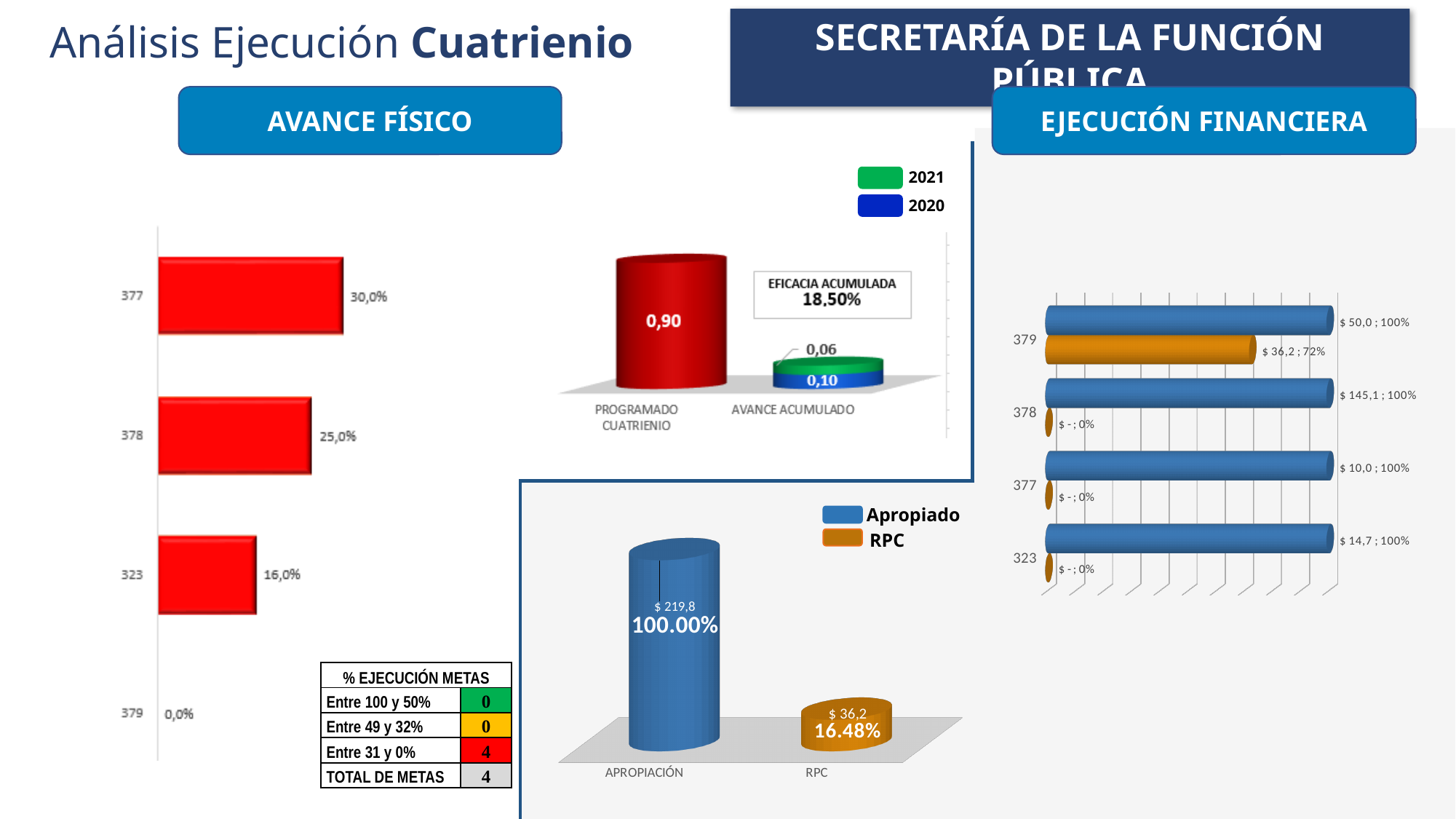
In the cylinder chart with PROGRAMADO CUATRIENIO and AVANCE ACUMULADO, what is the EFICACIA ACUMULADA shown? 18.50% In the cylinder chart with PROGRAMADO CUATRIENIO and AVANCE ACUMULADO, how many series does the legend list? 2 How many categories are shown in the red horizontal bar chart under AVANCE FÍSICO? 4 In the horizontal bar chart under EJECUCIÓN FINANCIERA, what is the RPC value for category 379? $ 36,2 ; 72% In the red horizontal bar chart under AVANCE FÍSICO, what is the difference between the values for 378 and 323? 9,0% In the bottom chart with APROPIACIÓN and RPC, what value is shown for RPC? $ 36,2 In the red horizontal bar chart under AVANCE FÍSICO, what is the value for category 377? 30,0% In the red horizontal bar chart under AVANCE FÍSICO, which category has the lowest value? 379 In the cylinder chart with PROGRAMADO CUATRIENIO and AVANCE ACUMULADO, what is the value for PROGRAMADO CUATRIENIO? 0,90 In the red horizontal bar chart under AVANCE FÍSICO, which category has the highest value? 377 In the horizontal bar chart under EJECUCIÓN FINANCIERA, what is the Apropiado value for category 378? $ 145,1 ; 100% In the bottom chart with APROPIACIÓN and RPC, what percentage is shown for APROPIACIÓN? 100.00%